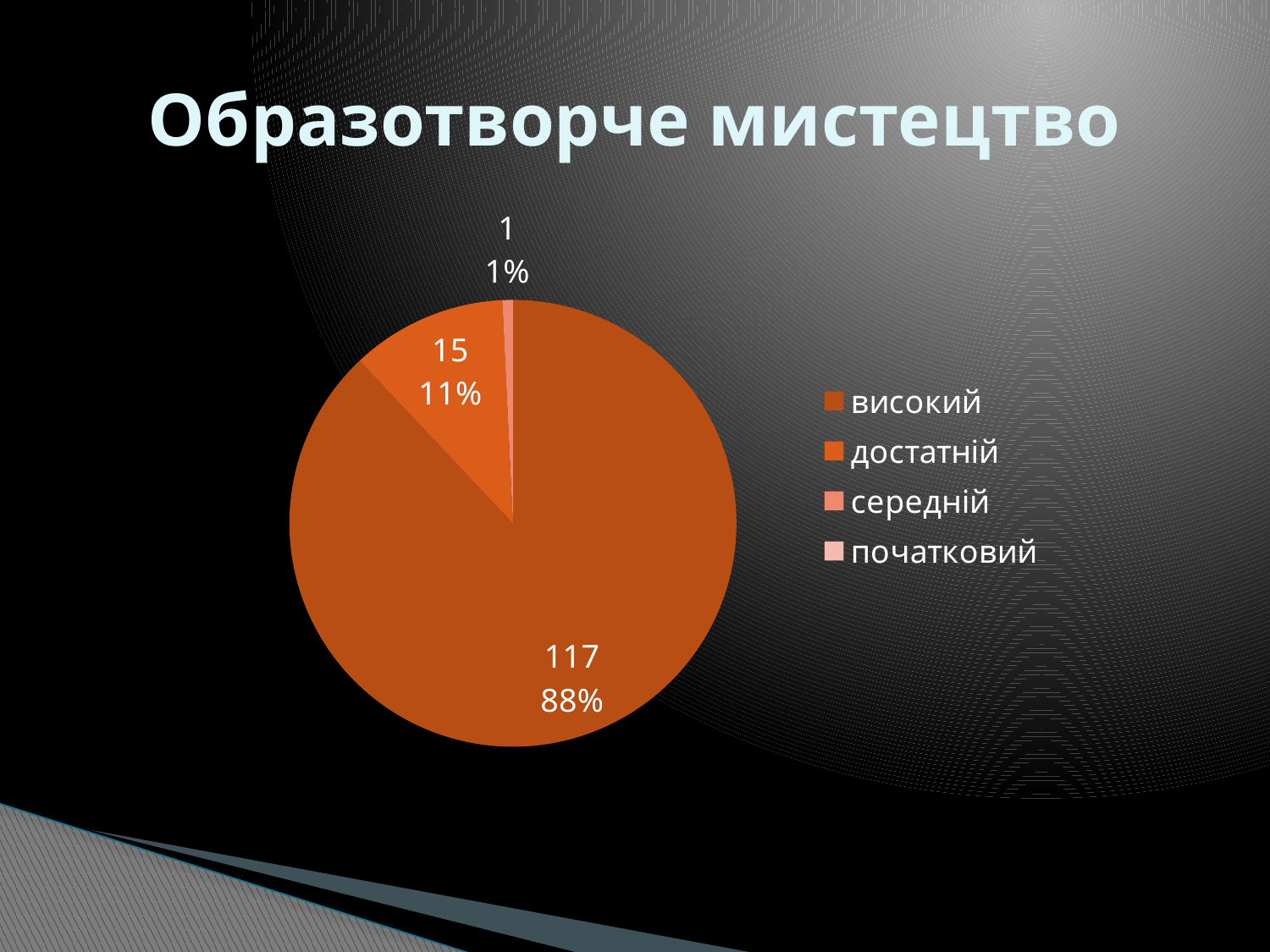
What share of the pie does середній take? 1% What is the value for високий? 117 What share of the pie does достатній take? 11% What is the value for середній? 1 Which is larger, the value for достатній or the value for середній? достатній What is the title of the chart? Образотворче мистецтво What is the value for достатній? 15 What is the difference between the values for високий and достатній? 102 What share of the pie does високий take? 88% Which category has the largest slice? високий What kind of chart is shown on the slide? pie chart How many entries does the legend list? 4